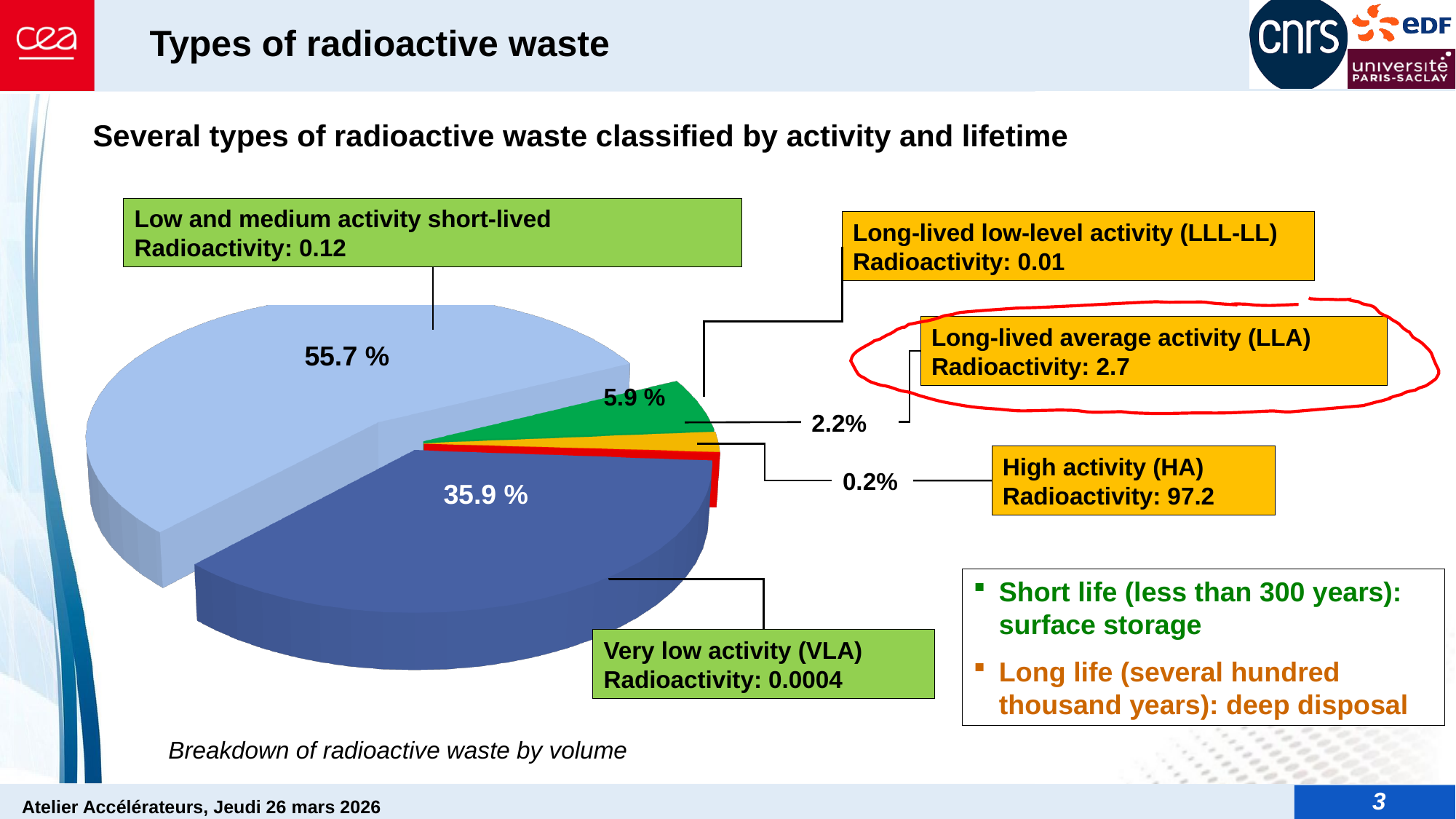
How many slices does the pie chart have? 5 What is the radioactivity value given for High activity (HA) waste? 97.2 What is the difference in percentage points between the Low and medium activity short-lived slice and the Very low activity (VLA) slice? 19.8 Which waste category has the smallest slice of the pie? High activity (HA) Which slice is larger: Long-lived low-level activity (LLL-LL) or Long-lived average activity (LLA)? Long-lived low-level activity (LLL-LL) What share of the pie does Long-lived low-level activity (LLL-LL) waste represent? 5.9 % What share of the pie does High activity (HA) waste represent? 0.2% What share of the pie does the Low and medium activity short-lived waste represent? 55.7 % What share of the pie does Very low activity (VLA) waste represent? 35.9 % What share of the pie does Long-lived average activity (LLA) waste represent? 2.2% What kind of chart is shown on the slide? pie chart Which waste category has the largest slice of the pie? Low and medium activity short-lived